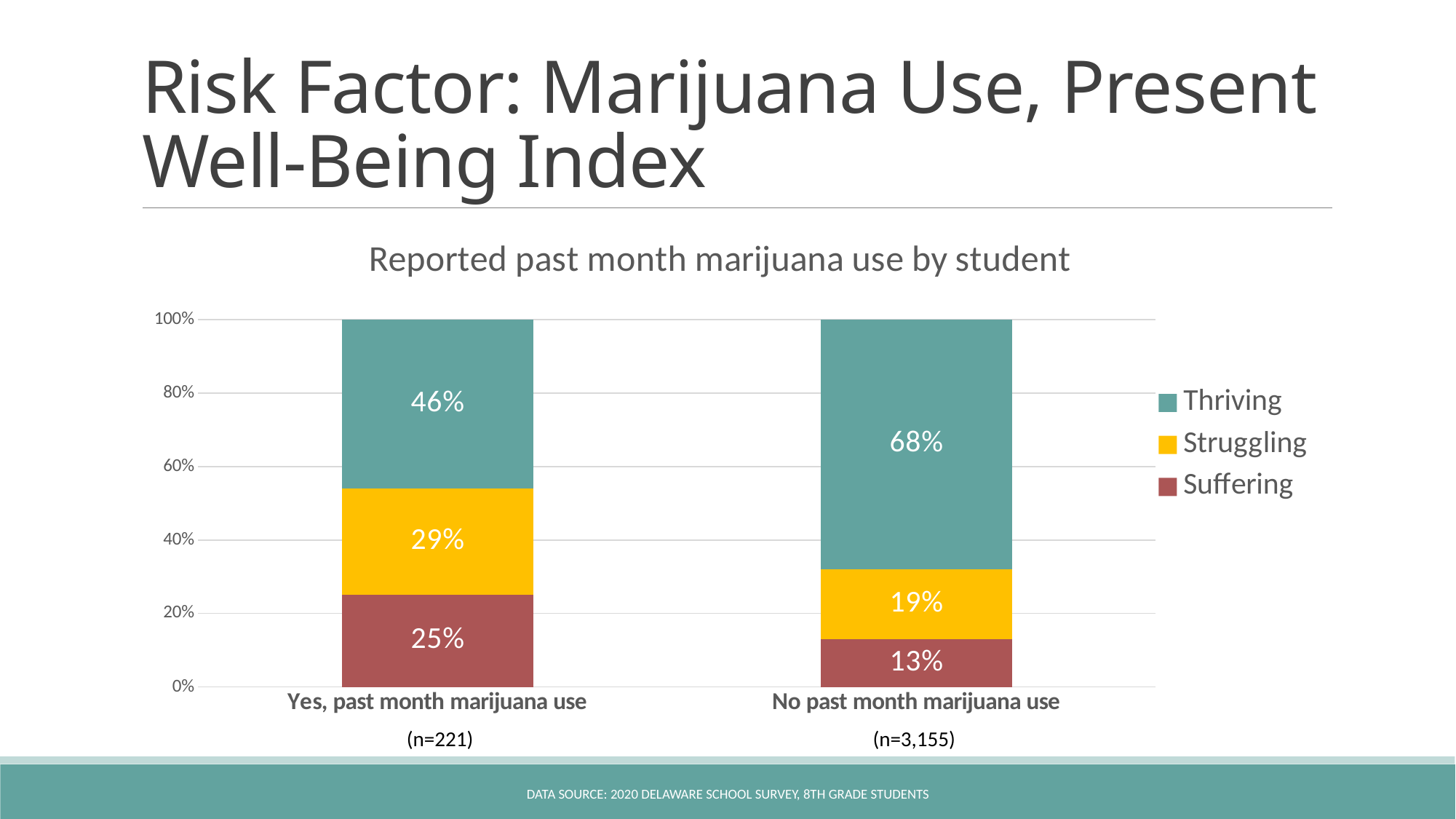
How many categories are shown on the x axis? 2 Which group has the higher Thriving percentage? No past month marijuana use What percentage of students with no past month marijuana use are Suffering? 13% How many series does the legend list? 3 What percentage of students with past month marijuana use are Thriving? 46% What is the Struggling value for the 'Yes, past month marijuana use' group? 29% What is the title of the chart? Reported past month marijuana use by student What is the difference in Struggling percentage between the two groups? 10% Which group has the higher Suffering percentage? Yes, past month marijuana use What is the difference in Thriving percentage between the 'No past month marijuana use' group and the 'Yes, past month marijuana use' group? 22% What is the Thriving value for the 'No past month marijuana use' group? 68% What kind of chart is shown on the slide? Stacked bar chart